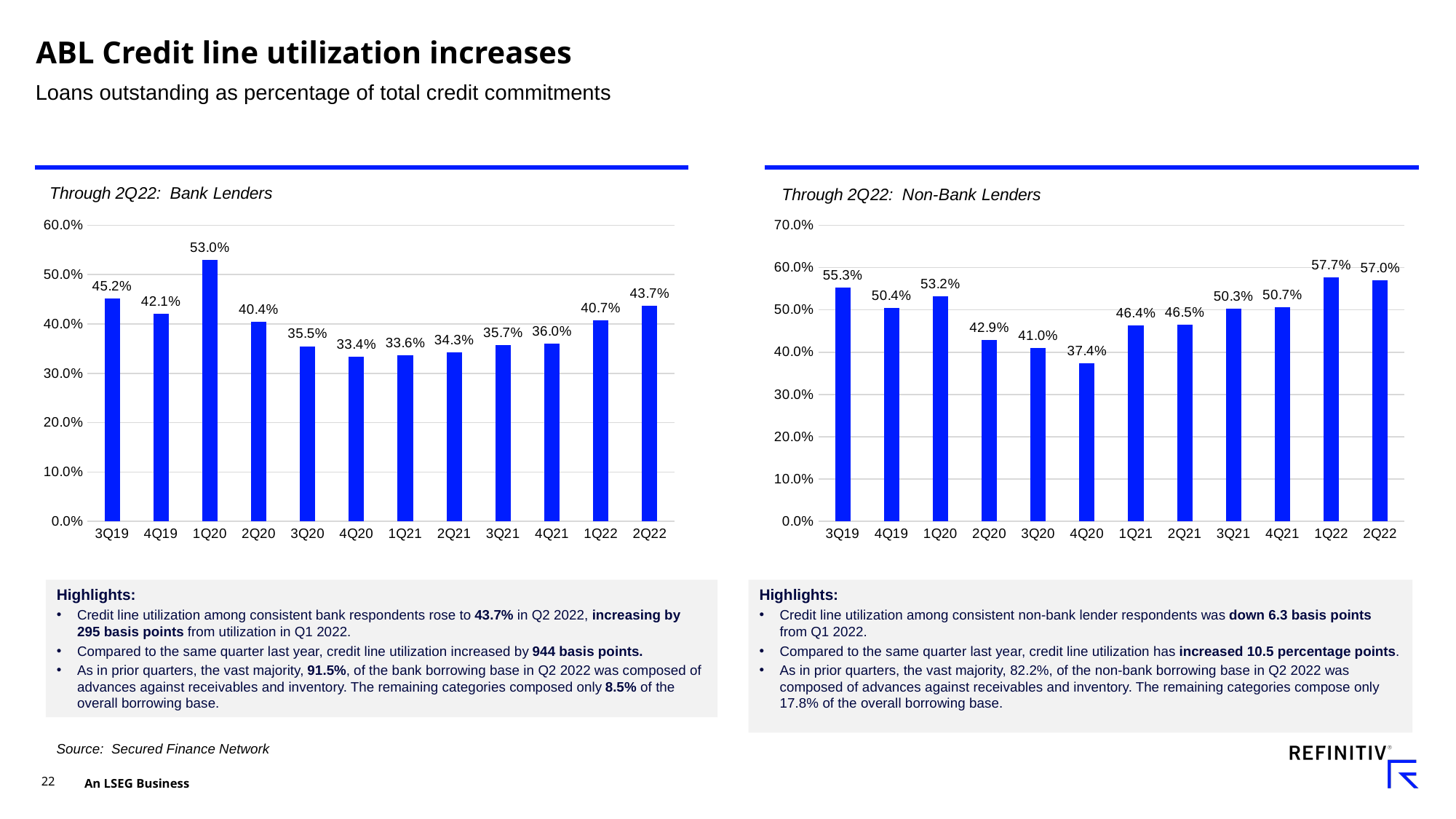
In the 'Through 2Q22: Non-Bank Lenders' chart, what is the difference between the values for 3Q19 and 4Q19? 4.9% What kind of chart is the 'Through 2Q22: Non-Bank Lenders' chart? bar chart In the 'Through 2Q22: Non-Bank Lenders' chart, which quarter has the highest value? 1Q22 What is the maximum value shown on the y axis of the 'Through 2Q22: Non-Bank Lenders' chart? 70.0% In the 'Through 2Q22: Bank Lenders' chart, what is the difference between the values for 2Q22 and 1Q22? 3.0% In the 'Through 2Q22: Non-Bank Lenders' chart, what is the value for 4Q20? 37.4% In the 'Through 2Q22: Bank Lenders' chart, what is the value for 1Q20? 53.0% In the 'Through 2Q22: Bank Lenders' chart, which quarter has the lowest value? 4Q20 In the 'Through 2Q22: Bank Lenders' chart, which is larger, the value for 3Q19 or the value for 2Q22? 3Q19 In the 'Through 2Q22: Non-Bank Lenders' chart, is the value for 2Q20 greater or less than 40.0%? greater In the 'Through 2Q22: Bank Lenders' chart, do the values rise or fall from 4Q20 to 2Q22? rise How many quarters are shown on the x axis of the 'Through 2Q22: Bank Lenders' chart? 12